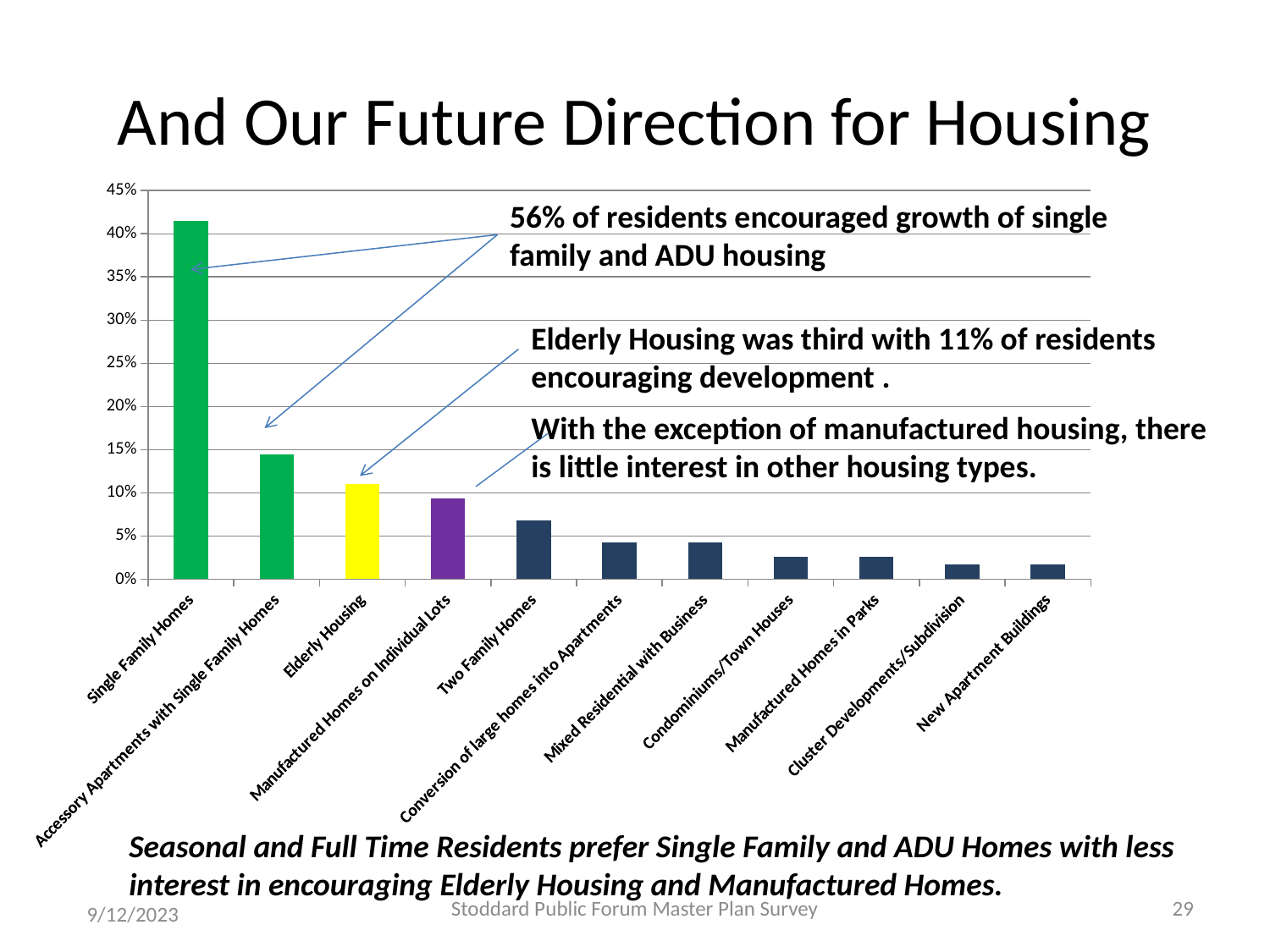
Which housing category has the highest value on the chart? Single Family Homes Is the value for Two Family Homes greater or less than 5%? greater Is the value for Condominiums/Town Houses greater or less than 5%? less Is the value for Single Family Homes greater or less than 40%? greater Which is larger, the value for Single Family Homes or the value for Accessory Apartments with Single Family Homes? Single Family Homes How many housing categories are plotted on the chart? 11 Which is larger, the value for Elderly Housing or the value for Two Family Homes? Elderly Housing What kind of chart is shown on the slide? Bar chart What colour is the bar for Elderly Housing? Yellow Do the bar values rise or fall moving from left to right across the chart? Fall